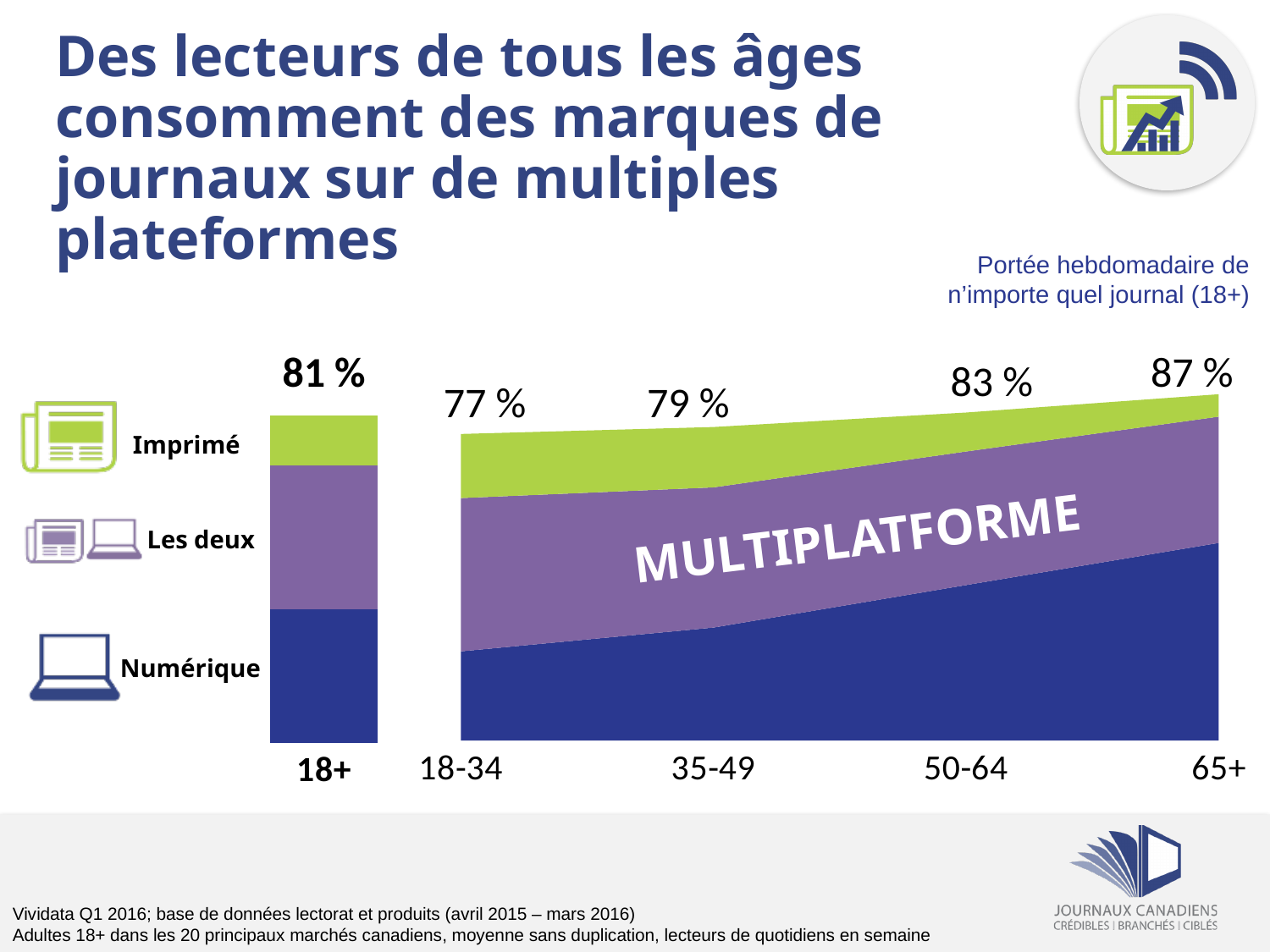
What is the value shown for the 50-64 age group? 83 % How many series (platform categories) does the legend list? 3 Which age group in the area chart has the highest weekly reach? 65+ What is the weekly reach value shown for the 18-34 age group? 77 % What is the total value shown above the 18+ stacked bar? 81 % Do the weekly reach values rise or fall as age increases from 18-34 to 65+? rise How many age groups are shown along the x axis of the area chart? 4 What is the difference between the values for the 65+ and 18-34 age groups? 10 % What is the weekly reach value shown for the 65+ age group? 87 % Which has a higher value, the 35-49 group or the 50-64 group? 50-64 What word is written across the middle band of the area chart? MULTIPLATFORME Which age group in the area chart has the lowest weekly reach? 18-34